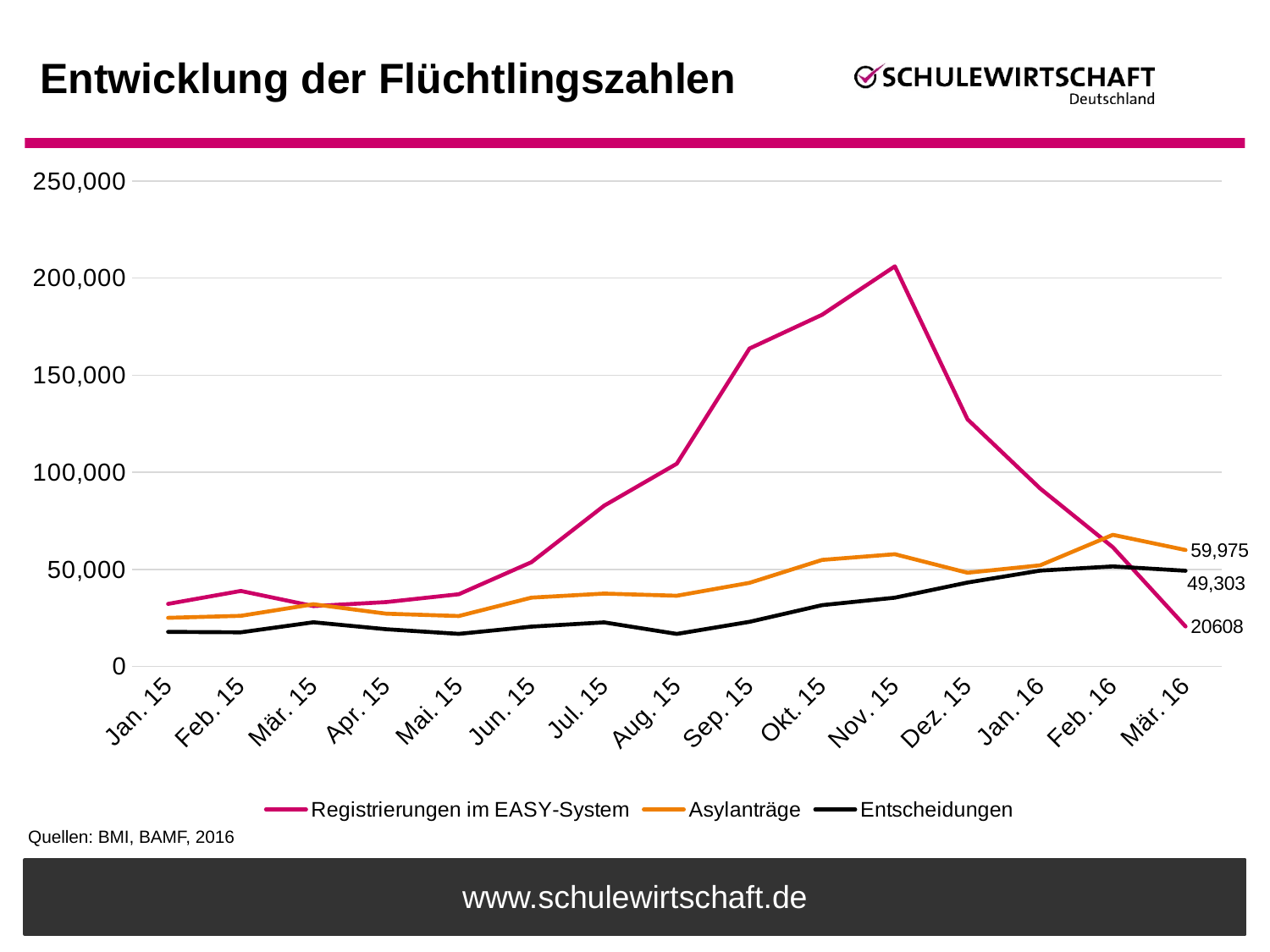
What is the value for Registrierungen im EASY-System in Mär. 16? 20608 Is the value for Registrierungen im EASY-System in Nov. 15 greater or less than 150,000? greater What is the value for Asylanträge in Mär. 16? 59,975 In Mär. 16, which is larger: Asylanträge or Entscheidungen? Asylanträge What kind of chart is shown on the slide? line chart What is the value for Entscheidungen in Mär. 16? 49,303 Is the value for Entscheidungen in Jan. 15 greater or less than 50,000? less How many series does the legend list? 3 Do the Registrierungen im EASY-System rise or fall from Nov. 15 to Mär. 16? fall In which month do the Registrierungen im EASY-System reach their highest value? Nov. 15 How many months are shown along the x axis? 15 What is the difference between Asylanträge and Entscheidungen in Mär. 16? 10,672